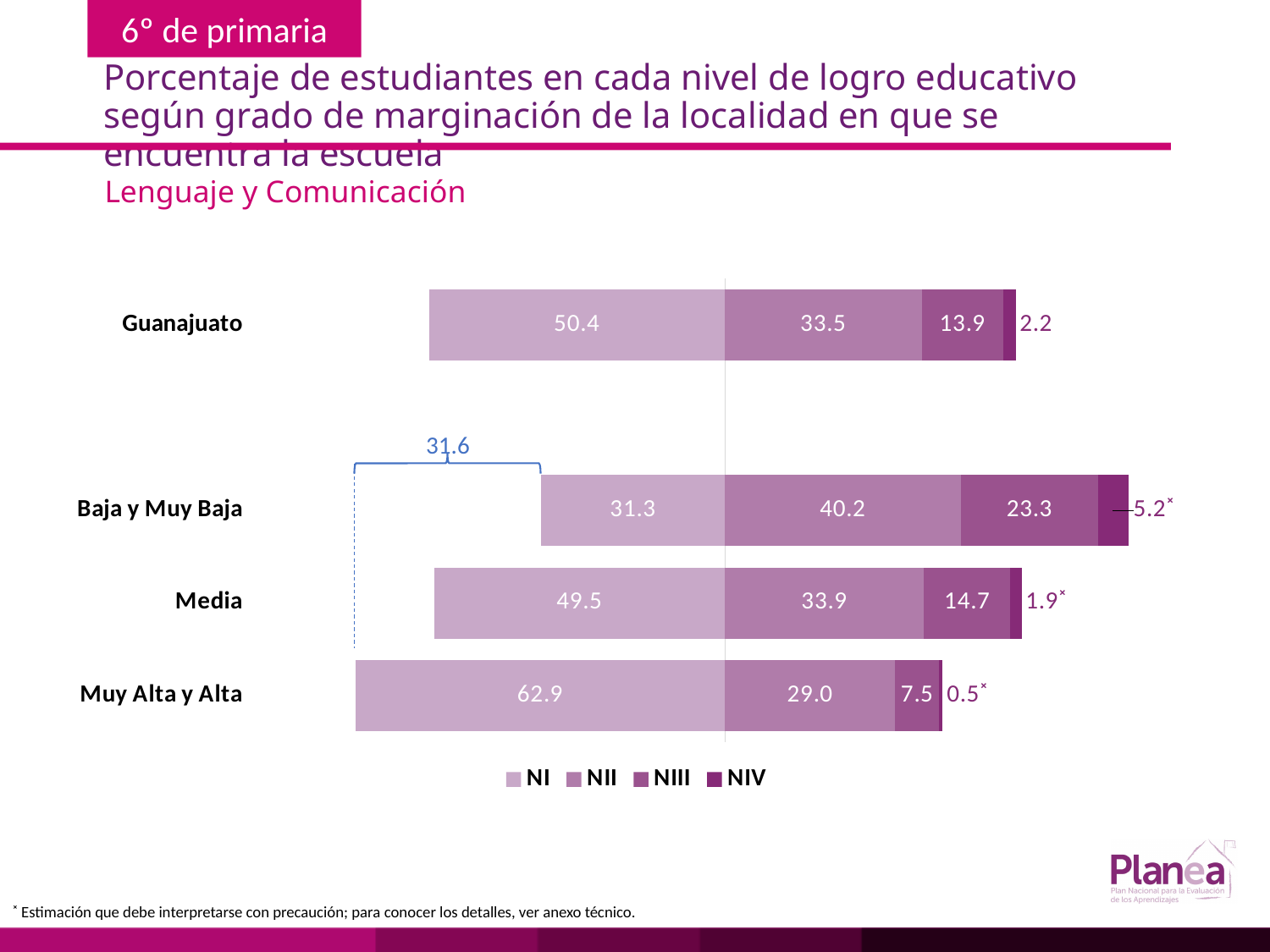
Which category has the lowest NI value? Baja y Muy Baja How many series does the legend list? 4 What is the NIV value for Media? 1.9 What is the NIII value for Muy Alta y Alta? 7.5 How many categories are shown on the chart? 4 Which is larger, the NIII value for Media or the NIII value for Muy Alta y Alta? Media What is the NII value for Baja y Muy Baja? 40.2 What is the NI value for Guanajuato? 50.4 Which category has the highest NI value? Muy Alta y Alta What kind of chart is shown on the slide? Stacked bar chart What is the difference between the NI value for Muy Alta y Alta and the NI value for Baja y Muy Baja? 31.6 What is the difference between the NIII value for Baja y Muy Baja and the NIII value for Guanajuato? 9.4